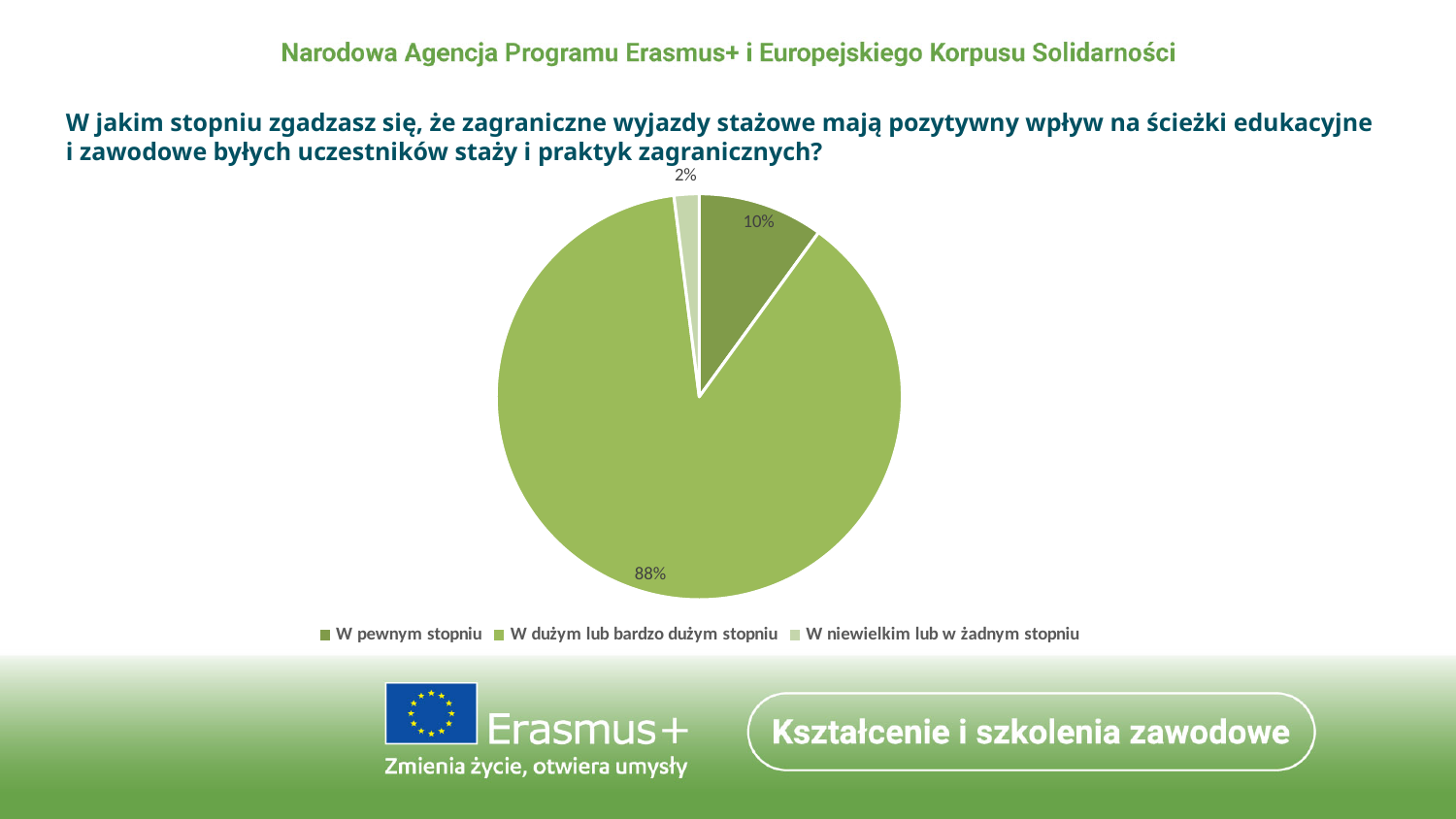
What share of the pie is labelled "W pewnym stopniu"? 10% What is the difference in percentage points between the "W dużym lub bardzo dużym stopniu" slice and the "W pewnym stopniu" slice? 78 What is the difference in percentage points between the "W pewnym stopniu" slice and the "W niewielkim lub w żadnym stopniu" slice? 8 What share of the pie is labelled "W dużym lub bardzo dużym stopniu"? 88% Which category has the smallest slice of the pie? W niewielkim lub w żadnym stopniu Which legend entry is shown in the lightest green colour? W niewielkim lub w żadnym stopniu How many entries does the legend list? 3 Which category has the largest slice of the pie? W dużym lub bardzo dużym stopniu How many slices does the pie chart have? 3 Which slice is larger: "W pewnym stopniu" or "W niewielkim lub w żadnym stopniu"? W pewnym stopniu What kind of chart is shown on the slide? pie chart What share of the pie is labelled "W niewielkim lub w żadnym stopniu"? 2%